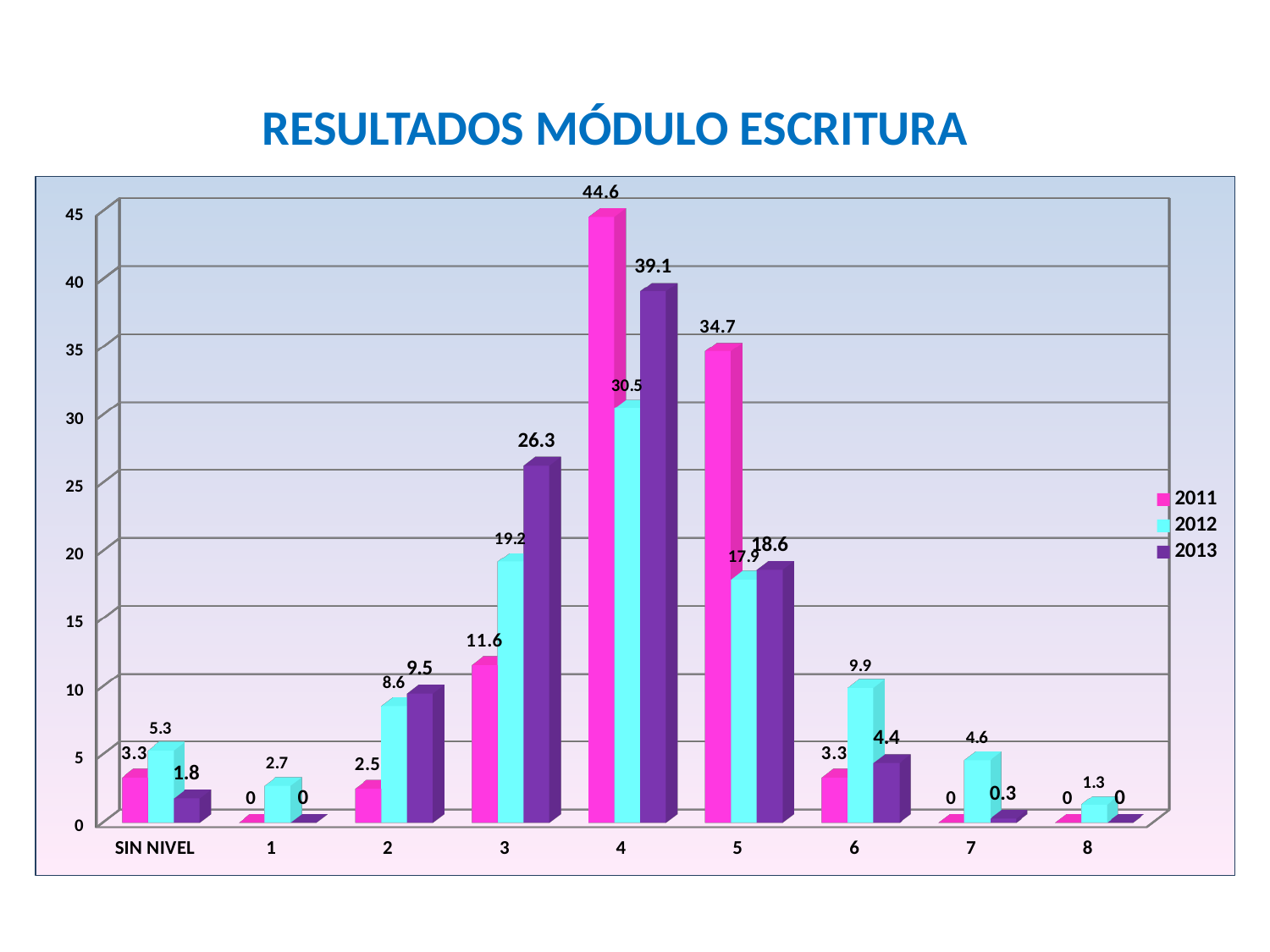
What is the value for 2012 at SIN NIVEL? 5.3 What is the value for 2011 at level 4? 44.6 How many categories are shown on the x axis? 9 What is the title of the chart? RESULTADOS MÓDULO ESCRITURA How many series does the legend list? 3 Which category has the highest value for the 2012 series? 4 What is the value for 2013 at level 3? 26.3 Which is larger at level 5: the 2011 value or the 2012 value? 2011 Which category has the highest value for the 2013 series? 4 What is the difference between the 2011 and 2013 values at level 4? 5.5 What is the difference between the 2012 and 2011 values at level 6? 6.6 What kind of chart is shown on the slide? bar chart